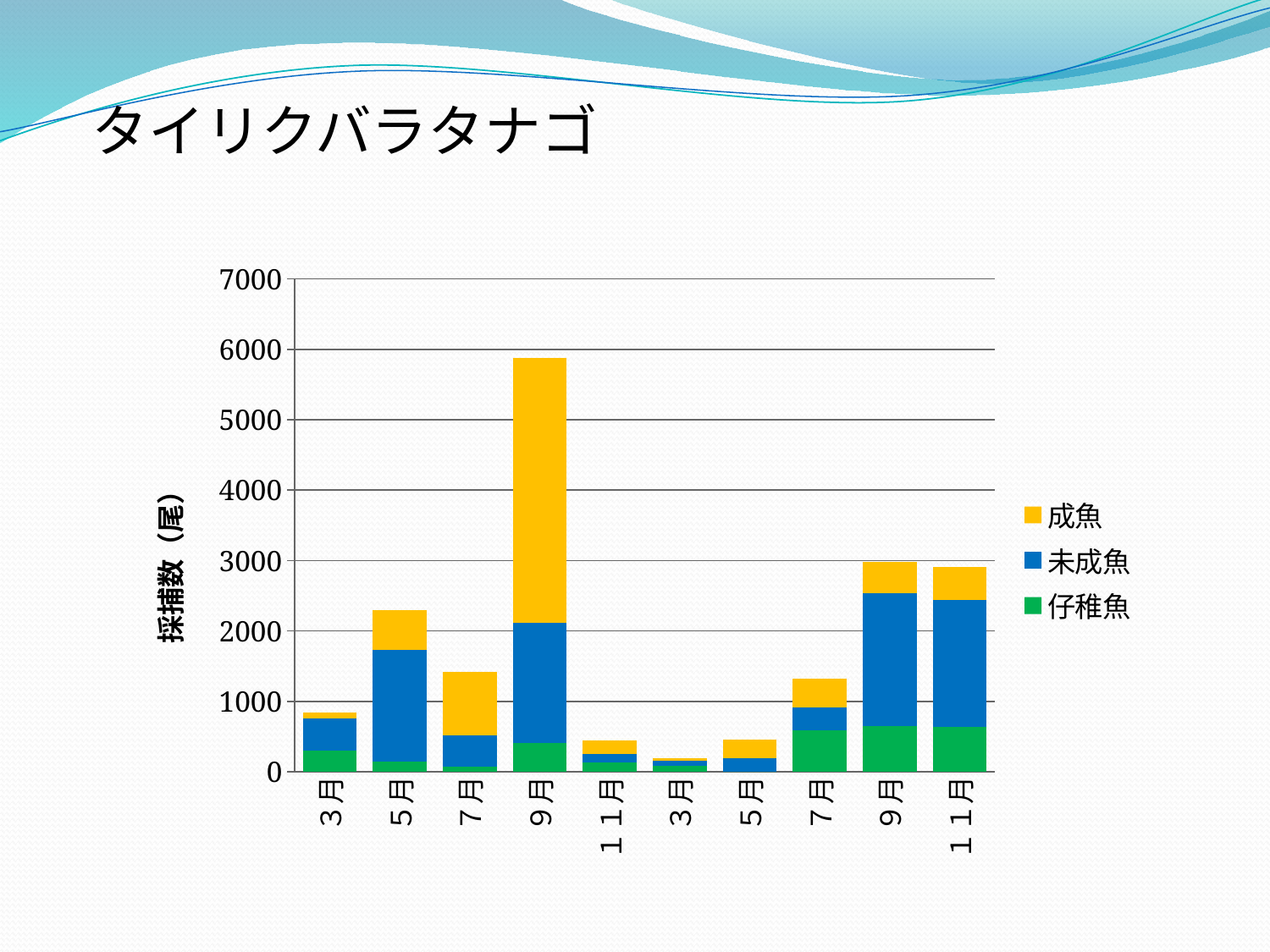
What kind of chart is shown on the slide? stacked bar chart What is the label of the vertical axis? 採捕数（尾） Is the total for the second 9月 bar greater or less than 2000? greater Which legend entry is shown in yellow? 成魚 Which bar has the highest total catch? the first 9月 (fourth bar) Which bar has the lowest total catch? the second 3月 (sixth bar) Is the total for the first 5月 bar greater or less than 2000? greater How many series does the legend list? 3 Is the total for the first 3月 bar greater or less than 1000? less Which is larger, the total for the first 9月 bar or the second 9月 bar? the first 9月 bar How many bars (month categories) are plotted along the x axis? 10